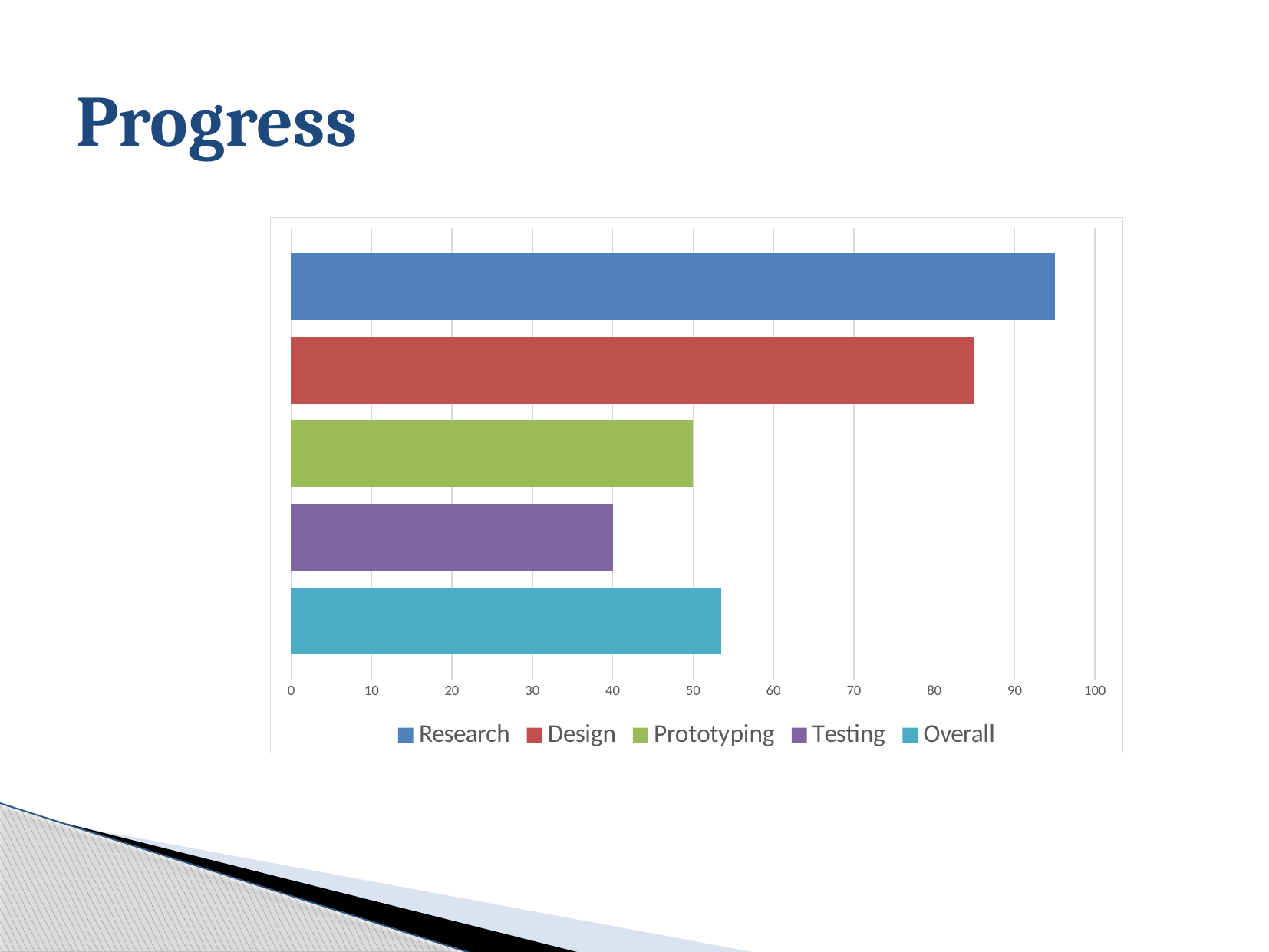
Which series has the lowest value? Testing What is the title of the slide containing the chart? Progress Is the value for Overall greater or less than 60? less Is the value for Design greater or less than 80? greater What type of chart is shown on the slide? bar chart Which is larger, the value for Design or the value for Overall? Design How many series does the legend list? 5 What is the value for Prototyping? 50 What is the value for Testing? 40 Which series has the highest value? Research Is the value for Research greater or less than 90? greater How many bars are plotted in the chart? 5